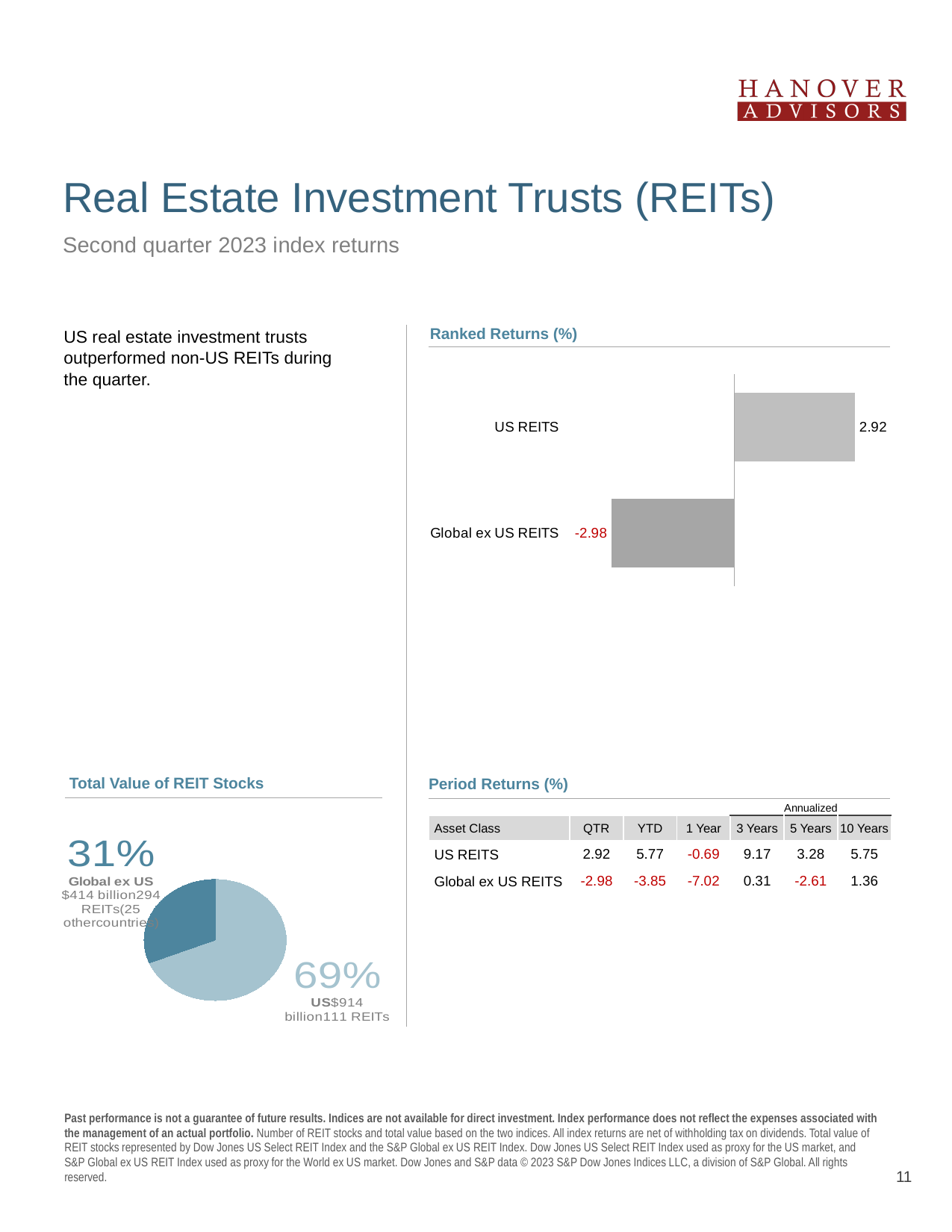
In the Ranked Returns (%) chart, which category has the lowest value? Global ex US REITS What kind of chart is the Ranked Returns (%) chart? Bar chart In the Total Value of REIT Stocks chart, what share of the pie is US? 69% What kind of chart is the Total Value of REIT Stocks chart? Pie chart In the Total Value of REIT Stocks chart, what share of the pie is Global ex US? 31% In the Ranked Returns (%) chart, which is larger, the value for US REITS or the value for Global ex US REITS? US REITS In the Ranked Returns (%) chart, what is the difference between the US REITS value and the Global ex US REITS value? 5.90 In the Ranked Returns (%) chart, what is the value for US REITS? 2.92 In the Ranked Returns (%) chart, how many categories are plotted? 2 In the Ranked Returns (%) chart, what is the value for Global ex US REITS? -2.98 In the Ranked Returns (%) chart, which category has the highest value? US REITS In the Total Value of REIT Stocks chart, which slice is the largest? US